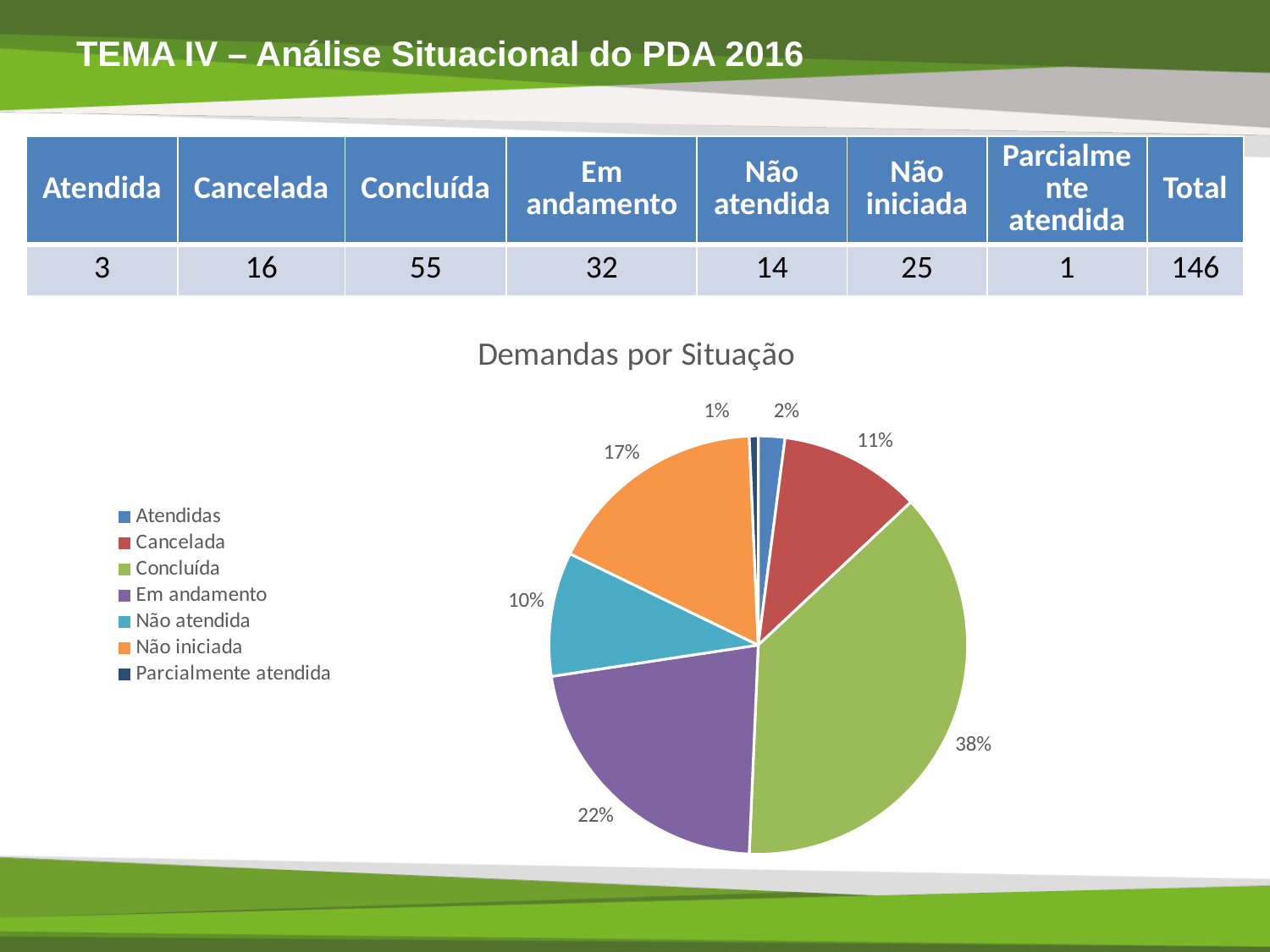
What is the title of the chart? Demandas por Situação Which is larger, the slice for Não iniciada or the slice for Não atendida? Não iniciada What percentage is shown for Não atendida? 10% How many slices does the pie chart have? 7 What percentage is shown for Cancelada? 11% Which category has the smallest slice of the pie? Parcialmente atendida What share of the pie does Concluída represent? 38% Which category has the largest slice of the pie? Concluída What percentage is shown for Não iniciada? 17% What is the difference in percentage points between the Concluída slice and the Em andamento slice? 16 What percentage is shown for Em andamento? 22% What kind of chart is shown on the slide? pie chart